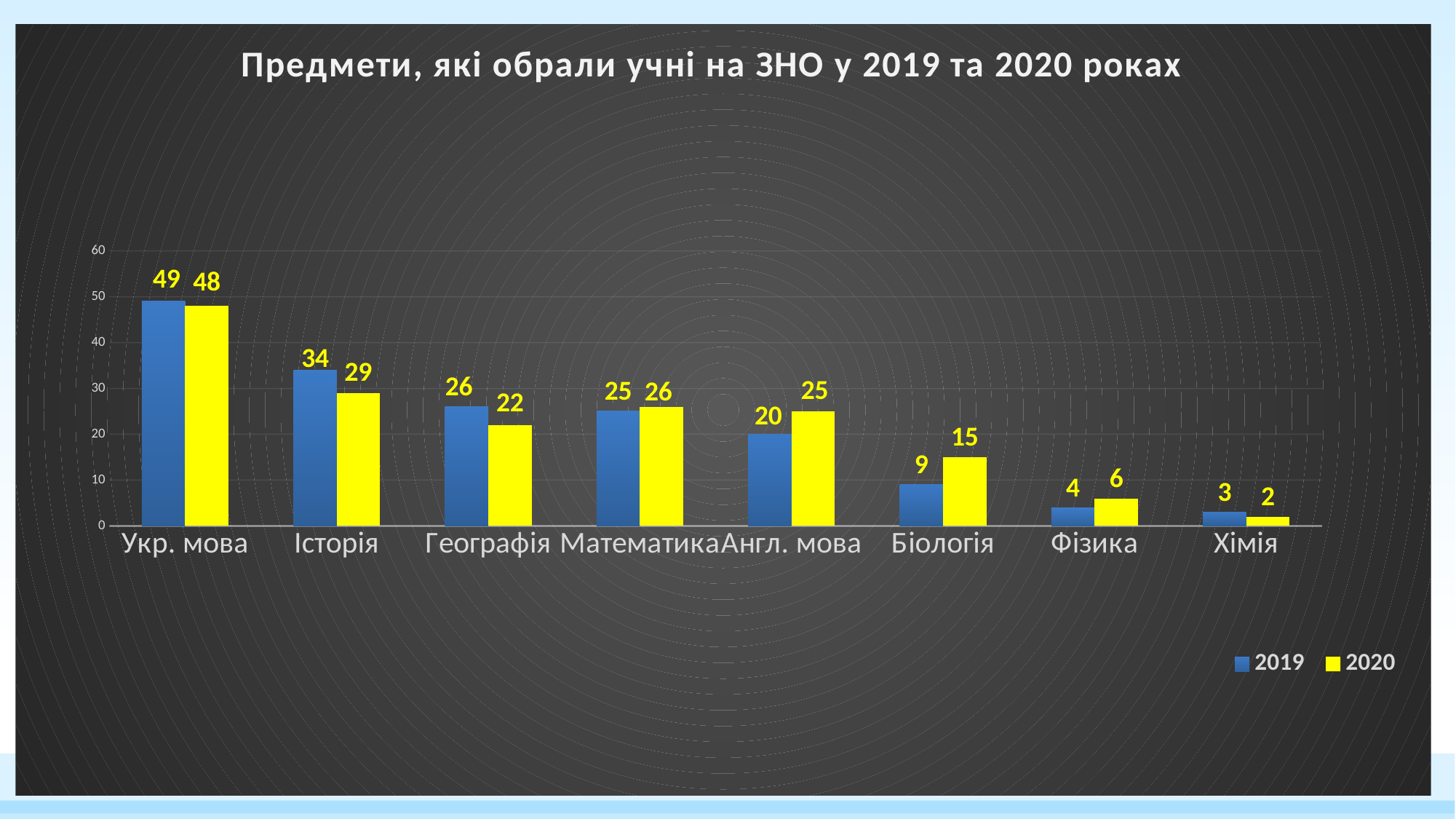
What is the title of the chart? Предмети, які обрали учні на ЗНО у 2019 та 2020 роках What kind of chart is shown on the slide? bar chart What is the difference between the 2020 values for Укр. мова and Географія? 26 Which is larger for Англ. мова: the 2019 value or the 2020 value? 2020 Which subject has the lowest value in the 2019 series? Хімія Which subject has the highest value in the 2020 series? Укр. мова What is the difference between the 2019 and 2020 values for Історія? 5 How many subjects are shown on the x axis? 8 What is the value for Історія in the 2019 series? 34 What is the value for Англ. мова in 2019? 20 What is the value for Біологія in the 2020 series? 15 How many series does the legend list? 2